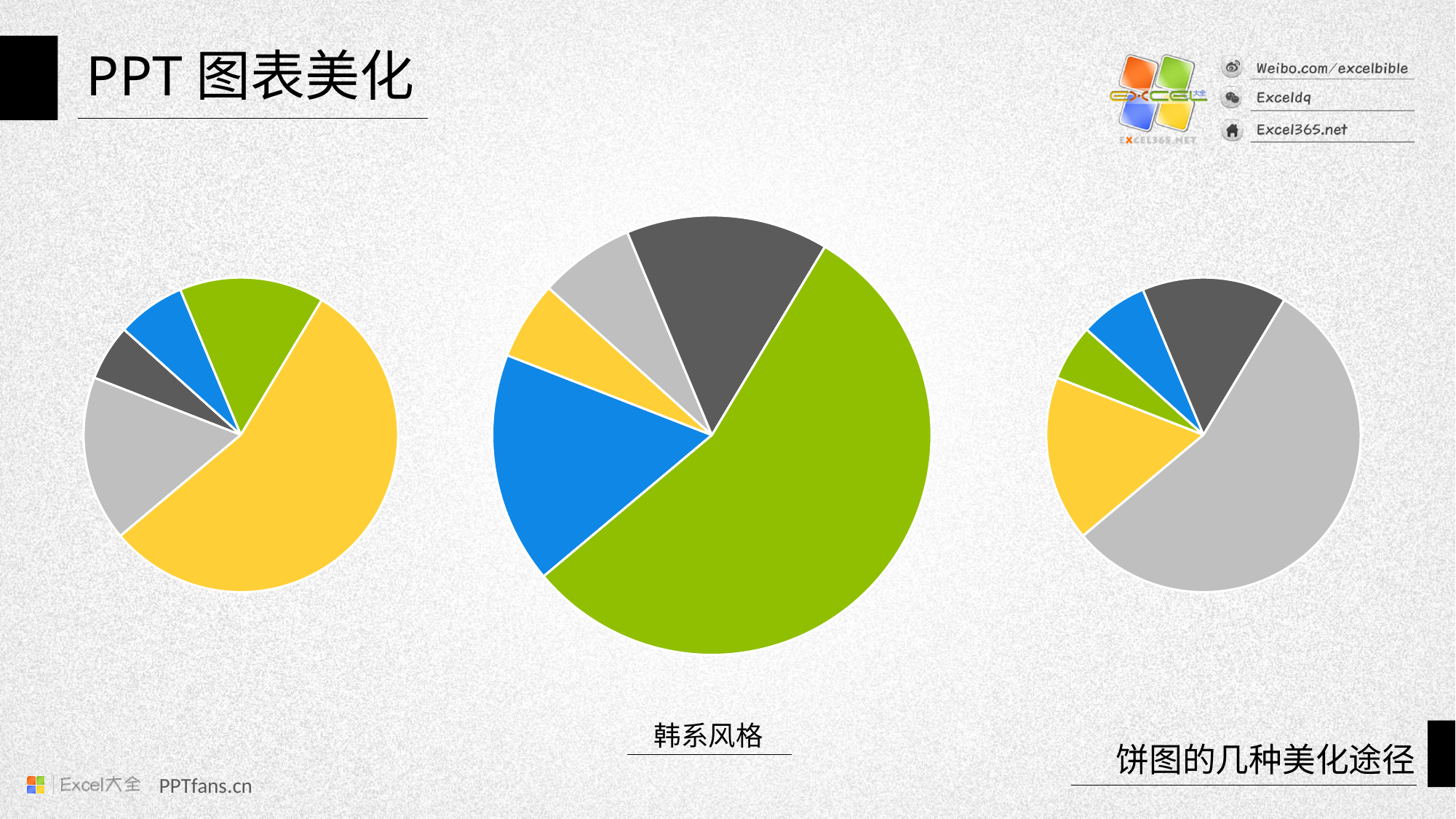
In the large pie chart in the middle of the slide, which colour slice is the largest? Green How many slices does the large pie chart in the middle of the slide have? 5 How many slices does the pie chart on the right of the slide have? 5 In the pie chart on the left of the slide, which colour slice is the largest? Yellow What caption is written below the large pie chart in the middle of the slide? 韩系风格 What kind of chart is the large chart in the middle of the slide? Pie chart In the pie chart on the right of the slide, which colour slice is the largest? Light gray In the large pie chart in the middle of the slide, which slice is larger, the blue one or the yellow one? Blue In the pie chart on the left of the slide, which slice is larger, the light gray one or the blue one? Light gray In the pie chart on the right of the slide, which slice is larger, the yellow one or the blue one? Yellow How many pie charts are shown on the slide? 3 How many slices does the pie chart on the left of the slide have? 5